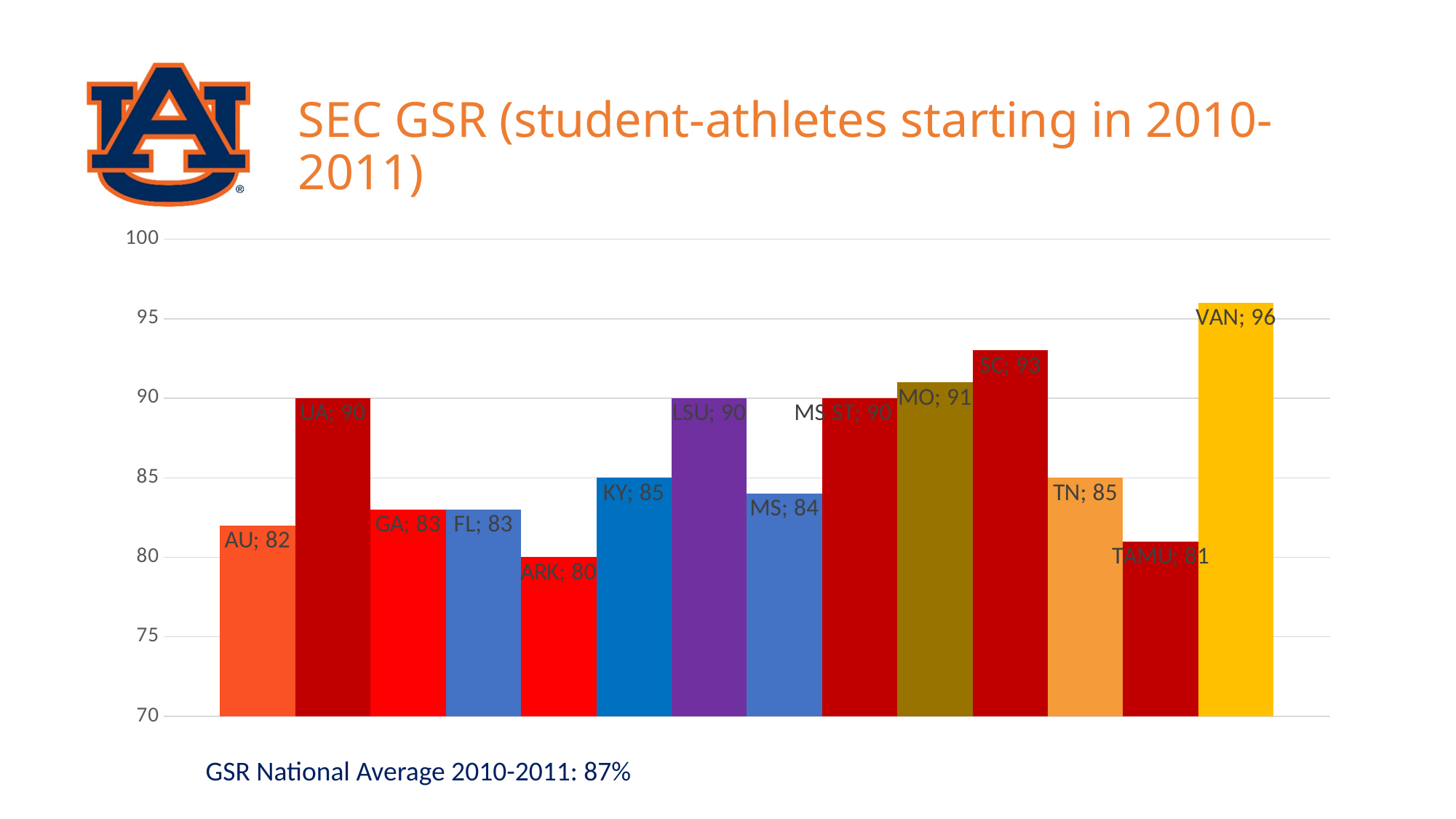
How many schools are shown on the chart? 14 What is the GSR value for VAN? 96 Which school has the highest GSR on the chart? VAN What is the difference between the GSR values for SC and TAMU? 12 What is the GSR value for MO? 91 Which has a higher GSR, KY or UA? UA What kind of chart is shown on the slide? bar chart What is the GSR value for AU? 82 Is the GSR value for SC greater or less than 90? greater What is the GSR National Average for 2010-2011 stated on the slide? 87% What is the difference between the GSR values for VAN and AU? 14 Which school has the lowest GSR on the chart? ARK